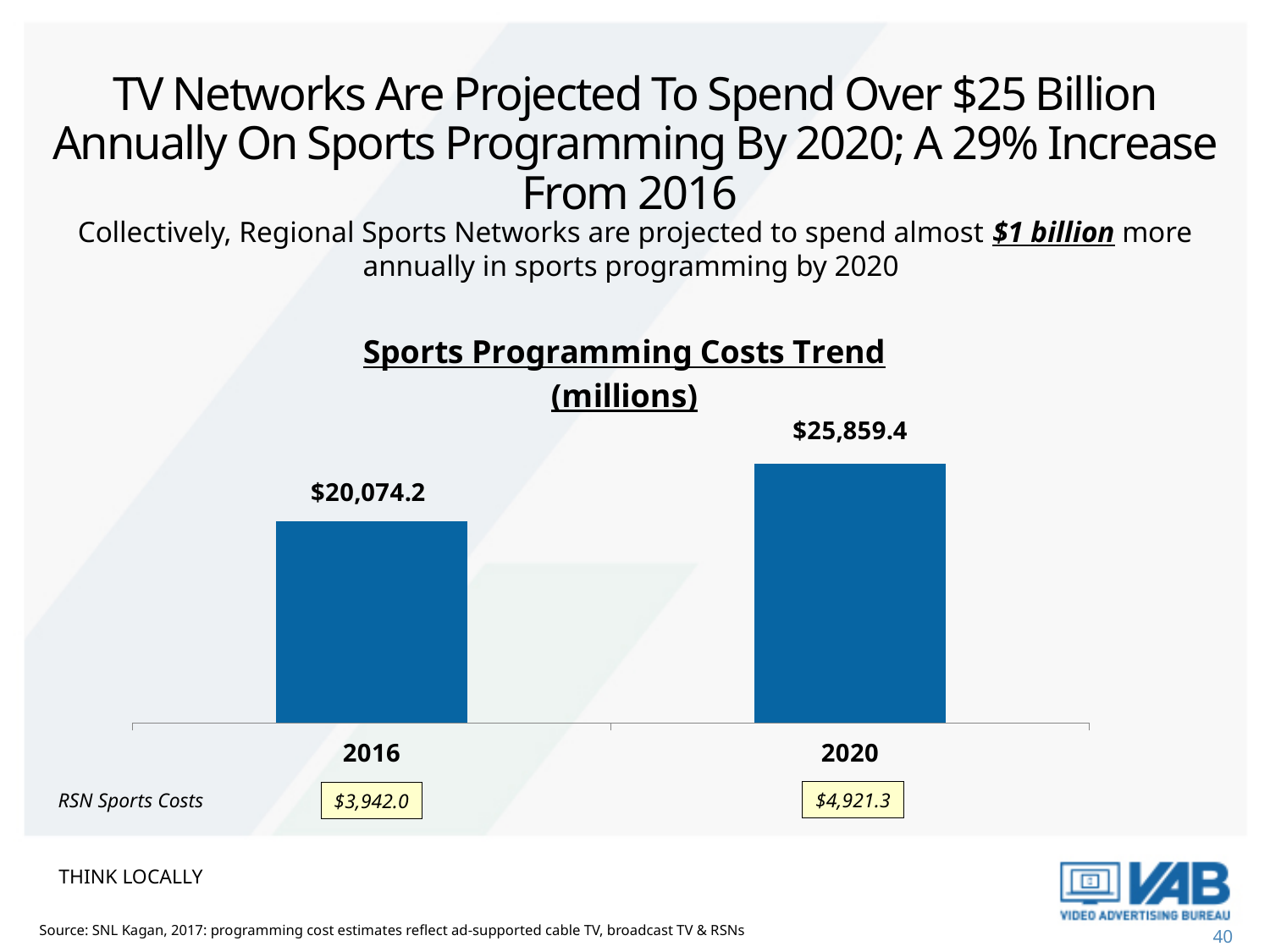
How many bars are plotted in the Sports Programming Costs Trend chart? 2 What is the value shown for 2020 in the Sports Programming Costs Trend chart? $25,859.4 Is the value for 2016 larger or smaller than the value for 2020? smaller What type of chart is used to show the Sports Programming Costs Trend? bar chart Which year has the lower sports programming cost in the chart? 2016 What unit is indicated in the chart title? millions What is the value shown for 2016 in the Sports Programming Costs Trend chart? $20,074.2 What is the title of the chart on the slide? Sports Programming Costs Trend (millions) Which year has the higher sports programming cost in the chart? 2020 What RSN Sports Costs value is shown beneath the 2020 bar? $4,921.3 Do the sports programming costs rise or fall from 2016 to 2020? rise By how much does the 2020 value exceed the 2016 value in the Sports Programming Costs Trend chart? $5,785.2